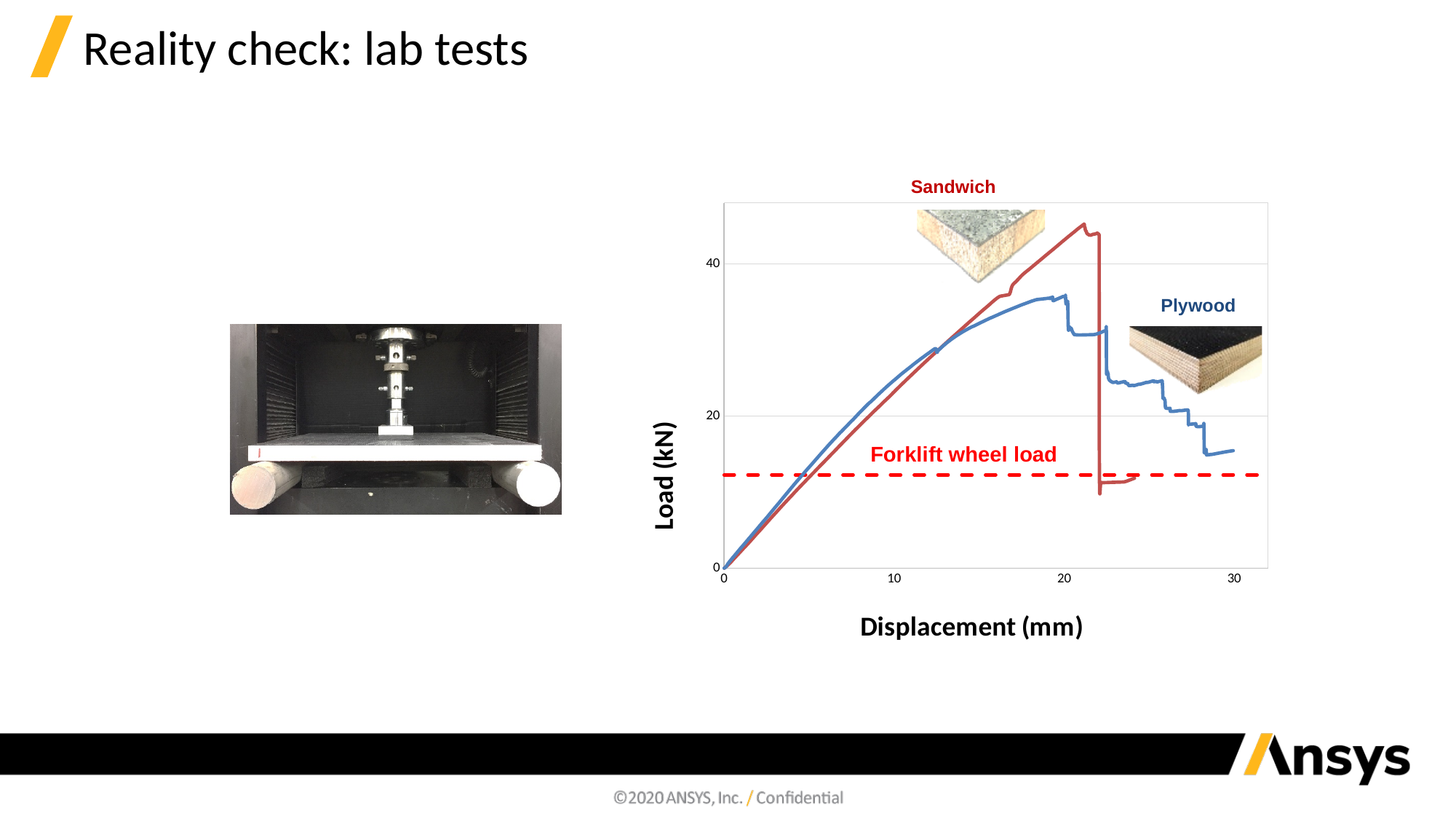
Is the peak load of the Plywood curve greater or less than 40 kN? less Which material reaches the higher peak load, Sandwich or Plywood? Sandwich Is the peak load of the Sandwich curve greater or less than 40 kN? greater Which curve is drawn in red, Sandwich or Plywood? Sandwich What is the title of the x axis of the chart? Displacement (mm) What kind of chart is shown on the slide? line chart Is the peak load of the Plywood curve greater or less than 20 kN? greater What is the highest value labelled on the y axis? 40 Does the Sandwich curve rise or fall between 0 mm and 20 mm displacement? rise